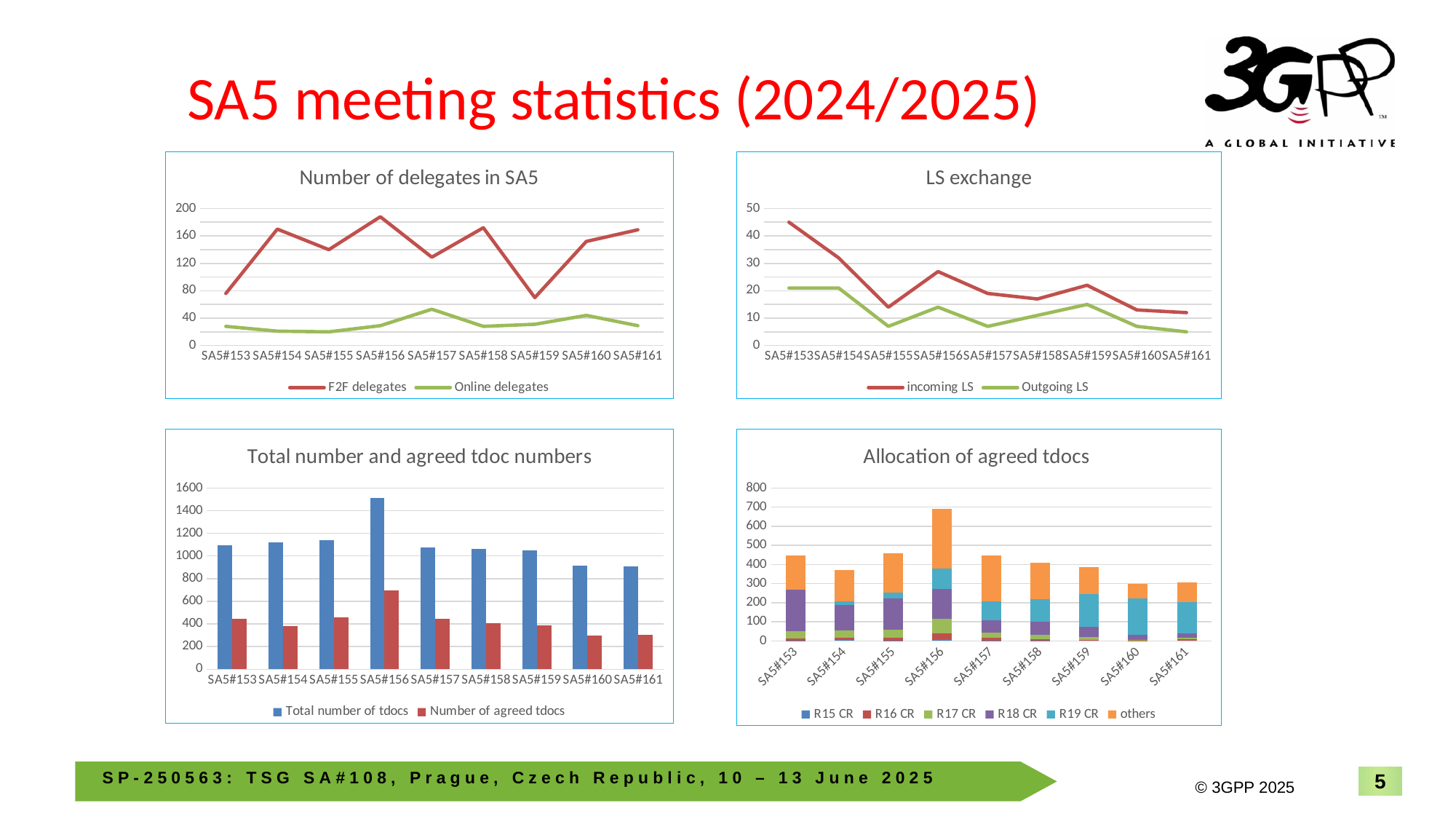
In the "Number of delegates in SA5" chart, at which meeting is the number of Online delegates highest? SA5#157 In the "Allocation of agreed tdocs" chart, how many meetings are shown on the x axis? 9 In the "LS exchange" chart, is the value for Outgoing LS at SA5#161 greater or less than 10? less In the "LS exchange" chart, which is larger at SA5#153: incoming LS or Outgoing LS? incoming LS How many series does the legend of the "Allocation of agreed tdocs" chart list? 6 In the "Total number and agreed tdoc numbers" chart, at which meeting is the Total number of tdocs highest? SA5#156 In the "LS exchange" chart, at which meeting is the number of incoming LS highest? SA5#153 What kind of chart is "Number of delegates in SA5"? line chart What kind of chart is "Total number and agreed tdoc numbers"? bar chart In the "Number of delegates in SA5" chart, is the value for F2F delegates at SA5#156 greater or less than 160? greater In the "Total number and agreed tdoc numbers" chart, is the Total number of tdocs at SA5#156 greater or less than 1400? greater